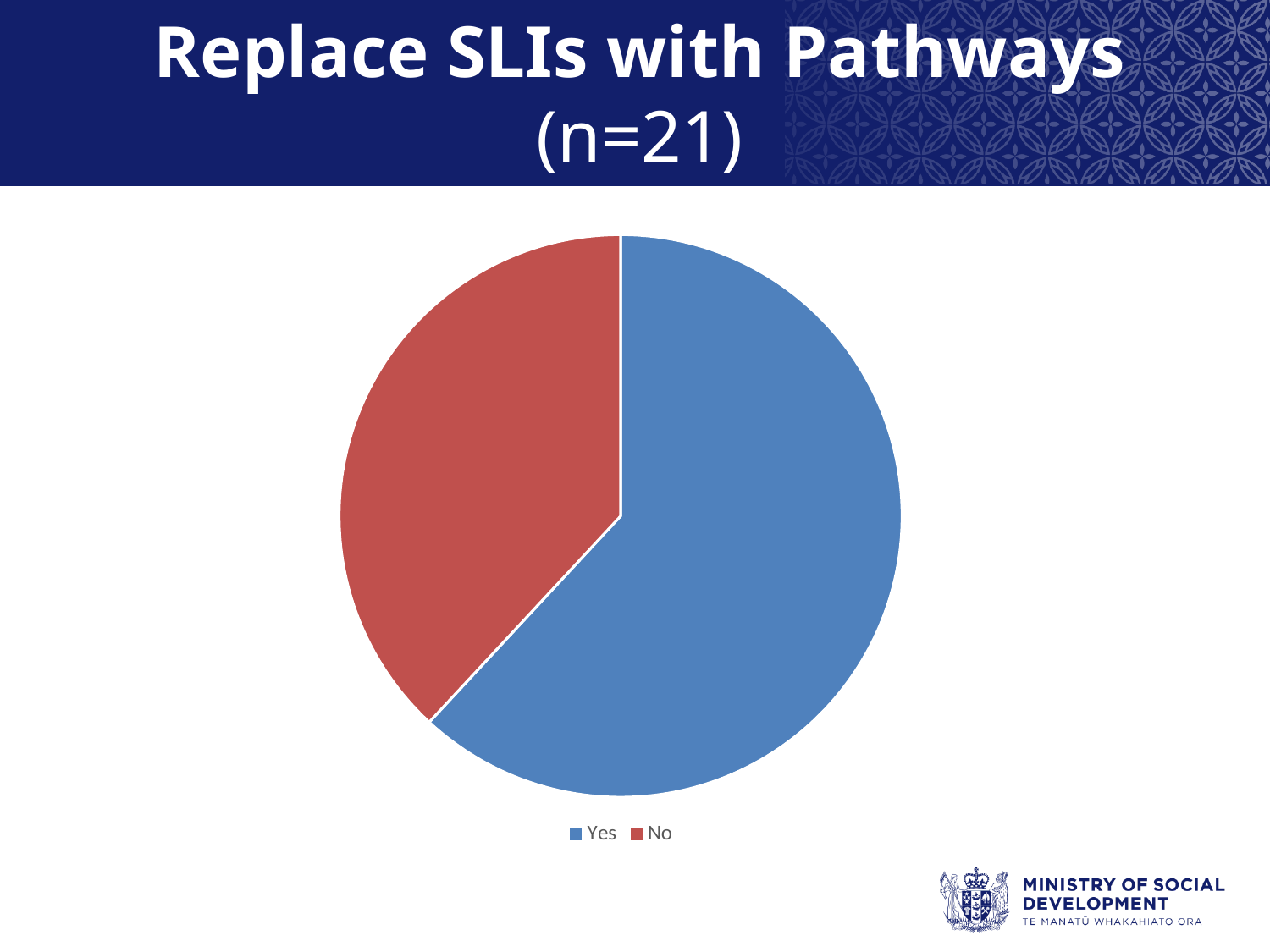
How many entries does the legend list? 2 How many slices does the pie chart have? 2 What kind of chart is shown on the slide? pie chart What colour represents the Yes category in the pie chart? blue Which category has the smallest slice of the pie? No Which category has the largest slice of the pie? Yes What are the two categories listed in the legend? Yes and No Which slice is larger, Yes or No? Yes Does the Yes slice take up more or less than half of the pie? more What is the title of the chart on the slide? Replace SLIs with Pathways (n=21)